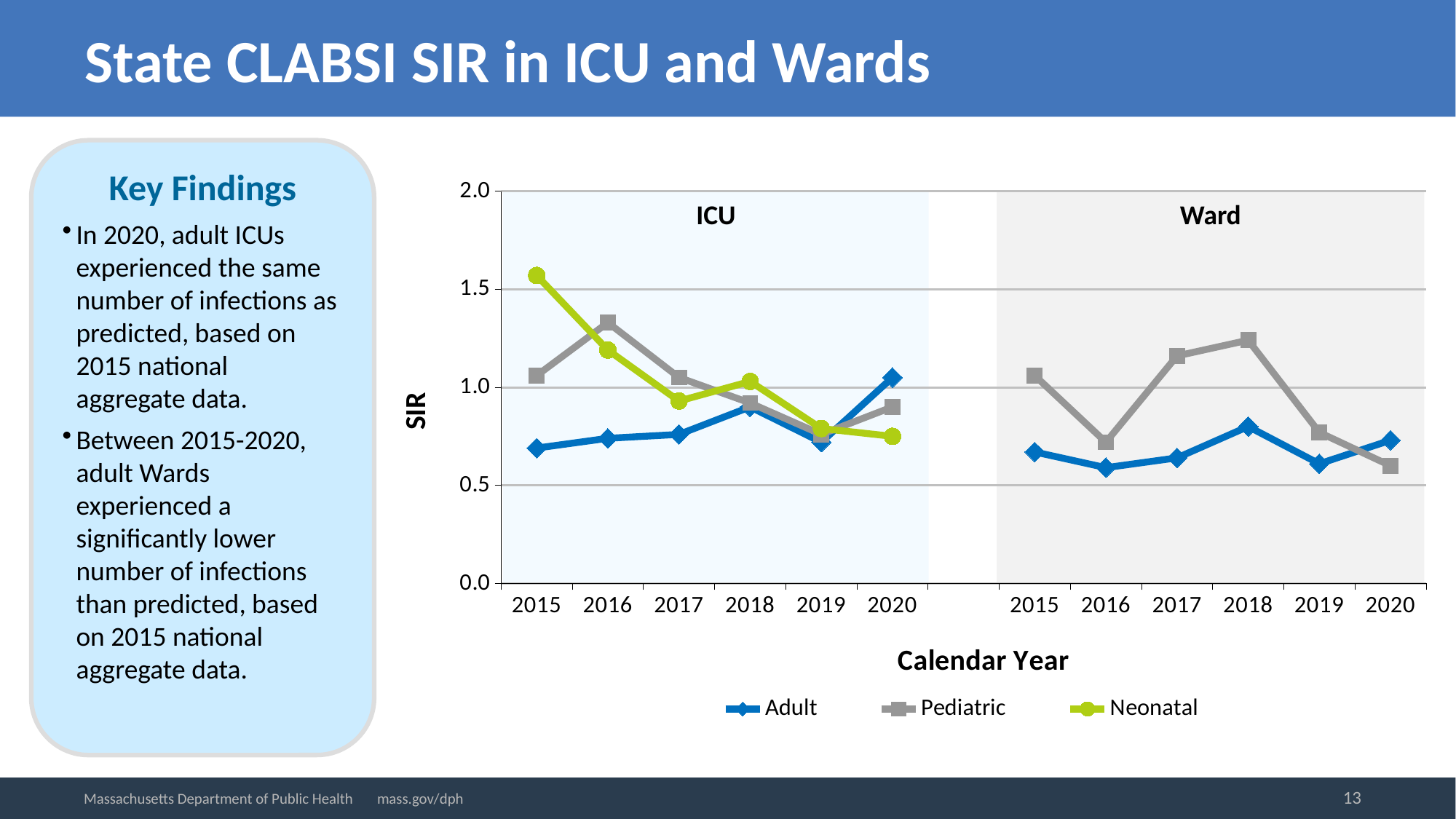
How many series does the legend list? 3 In the Ward panel, is the Pediatric SIR for 2016 greater or less than 1.0? less In the ICU panel, is the Neonatal SIR for 2015 greater or less than 1.5? greater Which series in the legend is plotted only in the ICU panel and not in the Ward panel? Neonatal What kind of chart is shown on the slide? line chart In the ICU panel for 2016, which series has the higher SIR, Adult or Pediatric? Pediatric In the Ward panel, in which year is the Pediatric SIR lowest? 2020 In the ICU panel, in which year is the Neonatal SIR highest? 2015 In the Ward panel, in which year is the Pediatric SIR highest? 2018 How many calendar years are plotted in the ICU panel? 6 In the ICU panel, is the Pediatric SIR for 2016 greater or less than 1.0? greater In the Ward panel for 2020, which series has the higher SIR, Adult or Pediatric? Adult